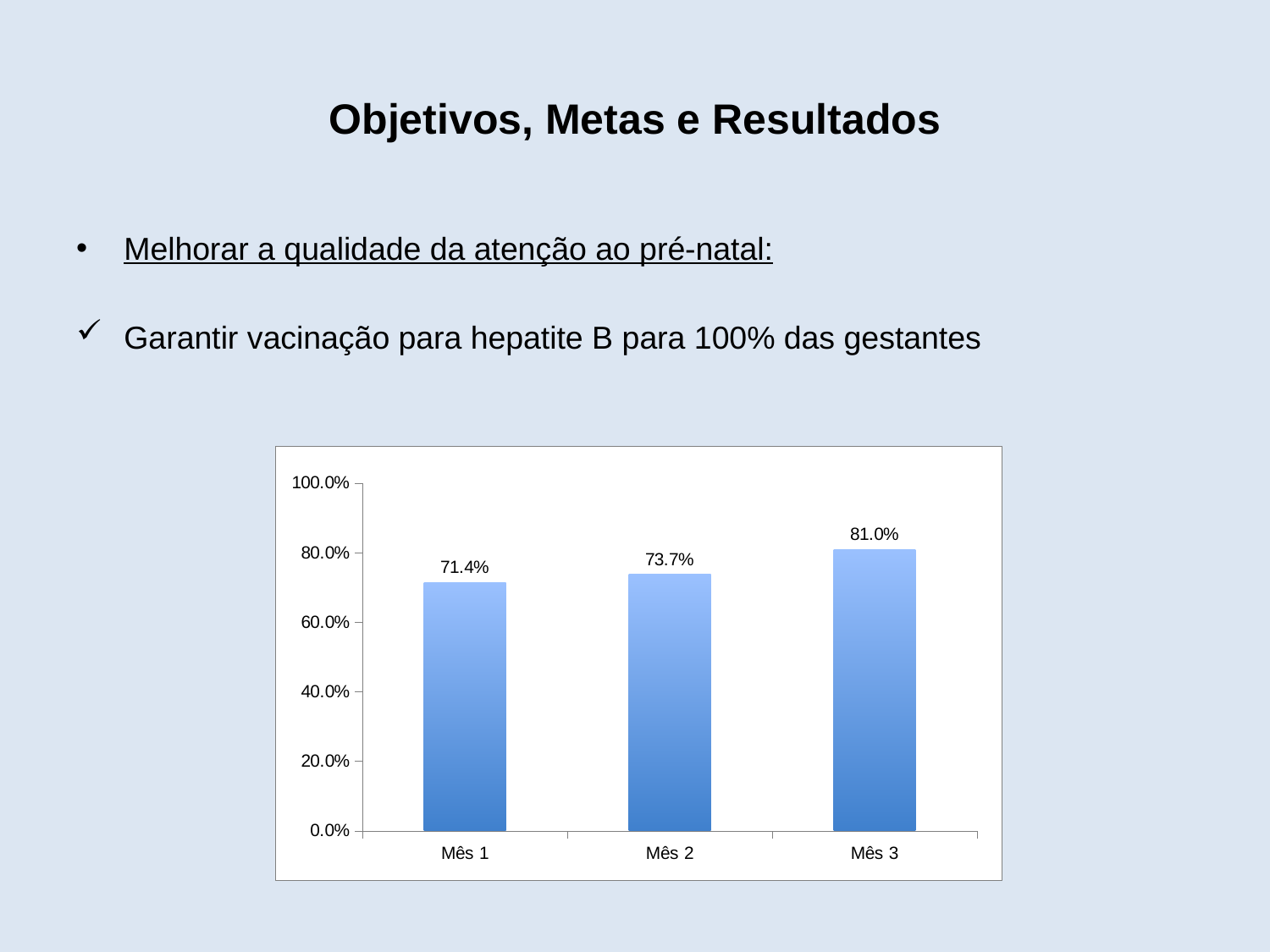
What is the value for Mês 1? 71.4% What is the value for Mês 2? 73.7% Which category has the highest value? Mês 3 Is the value for Mês 3 greater or less than 80.0%? greater Which category has the lowest value? Mês 1 How many categories are shown on the x axis? 3 Do the values rise or fall from Mês 1 to Mês 3? rise What is the difference between the values for Mês 2 and Mês 1? 2.3% What is the difference between the values for Mês 3 and Mês 1? 9.6% What is the value for Mês 3? 81.0% Which is larger, the value for Mês 2 or the value for Mês 3? Mês 3 What kind of chart is shown on the slide? bar chart